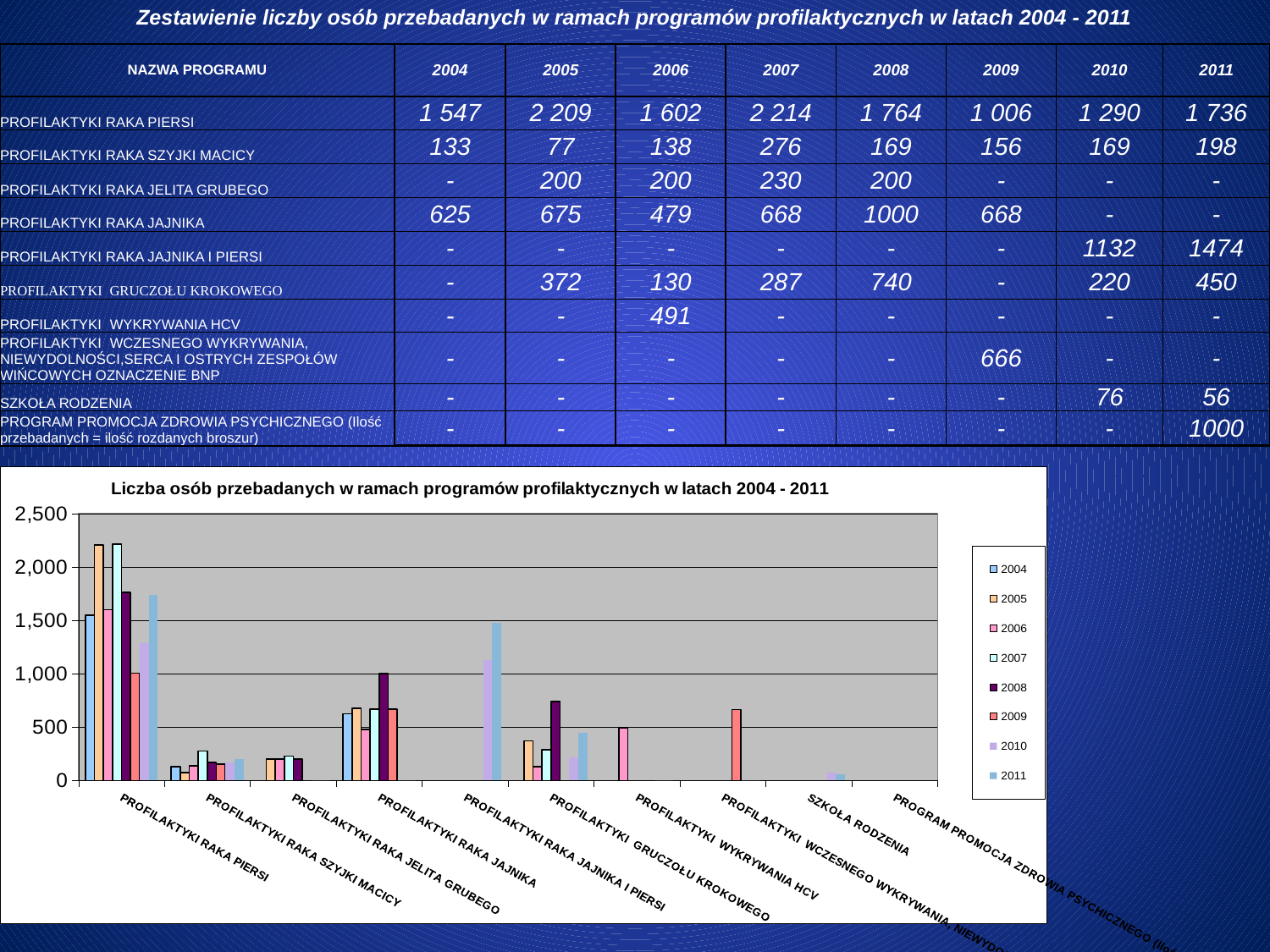
What is the value for PROFILAKTYKI WYKRYWANIA HCV in 2006? 491 What is the value for PROFILAKTYKI RAKA JAJNIKA in 2008? 1000 Which year has the lowest value for PROFILAKTYKI RAKA PIERSI? 2009 What type of chart is shown on the slide? bar chart What is the difference between the 2010 and 2011 values for SZKOŁA RODZENIA? 20 Is the 2009 value for PROFILAKTYKI RAKA PIERSI greater or less than 1,500? less Is the 2007 value for PROFILAKTYKI RAKA PIERSI greater or less than 2,000? greater How many programs (categories) are shown along the x axis of the chart? 10 Which program has the tallest bar in the chart? PROFILAKTYKI RAKA PIERSI For PROFILAKTYKI RAKA JAJNIKA I PIERSI, which year has the larger value, 2010 or 2011? 2011 How many series does the chart legend list? 8 What is the title of the chart? Liczba osób przebadanych w ramach programów profilaktycznych w latach 2004 - 2011